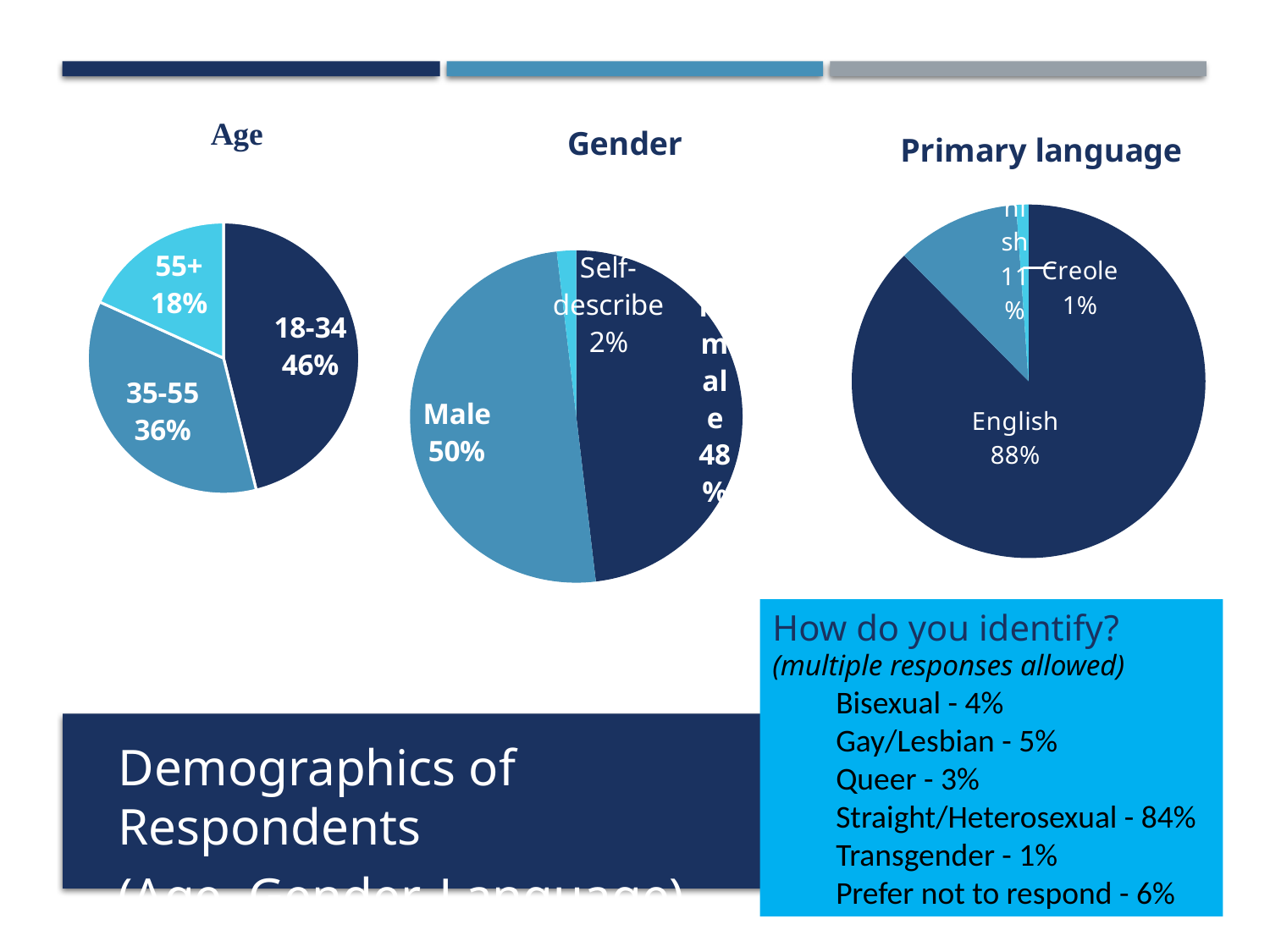
In the Age pie chart, which age group has the smallest share? 55+ In the Primary language pie chart, what share of respondents have Creole as their primary language? 1% In the Primary language pie chart, what share of respondents have English as their primary language? 88% In the Age pie chart, what share of respondents are aged 18-34? 46% In the Gender pie chart, what share of respondents chose Self-describe? 2% In the Age pie chart, which age group has the largest share? 18-34 In the Gender pie chart, what share of respondents are Male? 50% In the Age pie chart, how many slices are there? 3 In the Age pie chart, what share of respondents are aged 55+? 18% In the Age pie chart, how many percentage points larger is the 18-34 share than the 55+ share? 28 What type of chart is used for the Primary language data? Pie chart In the Age pie chart, what share of respondents are aged 35-55? 36%